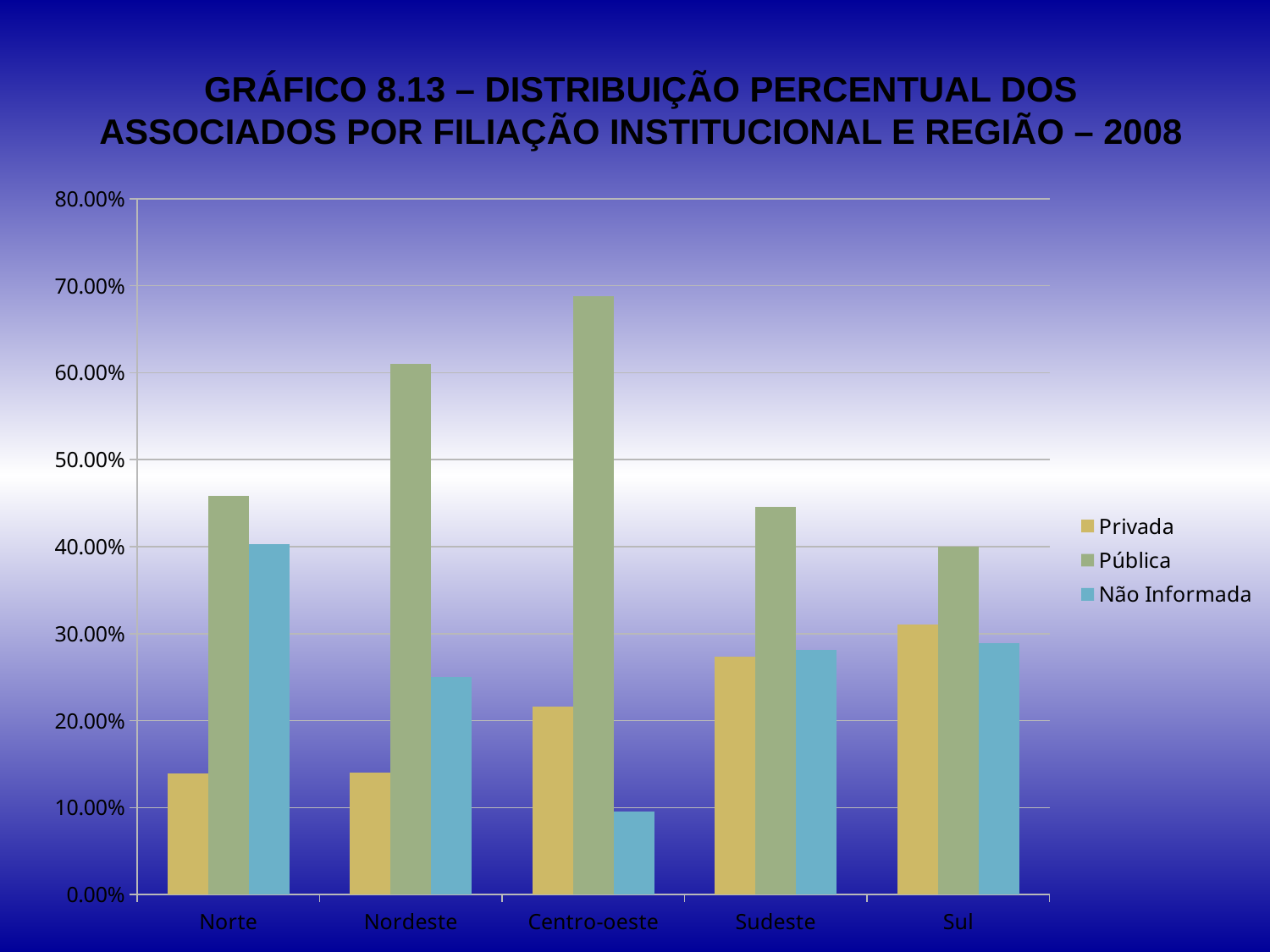
How many series does the legend list? 3 Is the value for Não Informada in Centro-oeste greater or less than 20.00%? less Do the Privada values generally rise or fall from Norte to Sul? rise Which region has the lowest value for Pública? Sul Is the value for Pública in Centro-oeste greater or less than 60.00%? greater In Norte, which is larger: Pública or Não Informada? Pública Which region has the lowest value for Não Informada? Centro-oeste What are the three series listed in the legend? Privada, Pública, Não Informada What kind of chart is shown on the slide? Bar chart How many regions are shown on the x axis? 5 Which region has the highest value for Privada? Sul Which region has the highest value for Pública? Centro-oeste